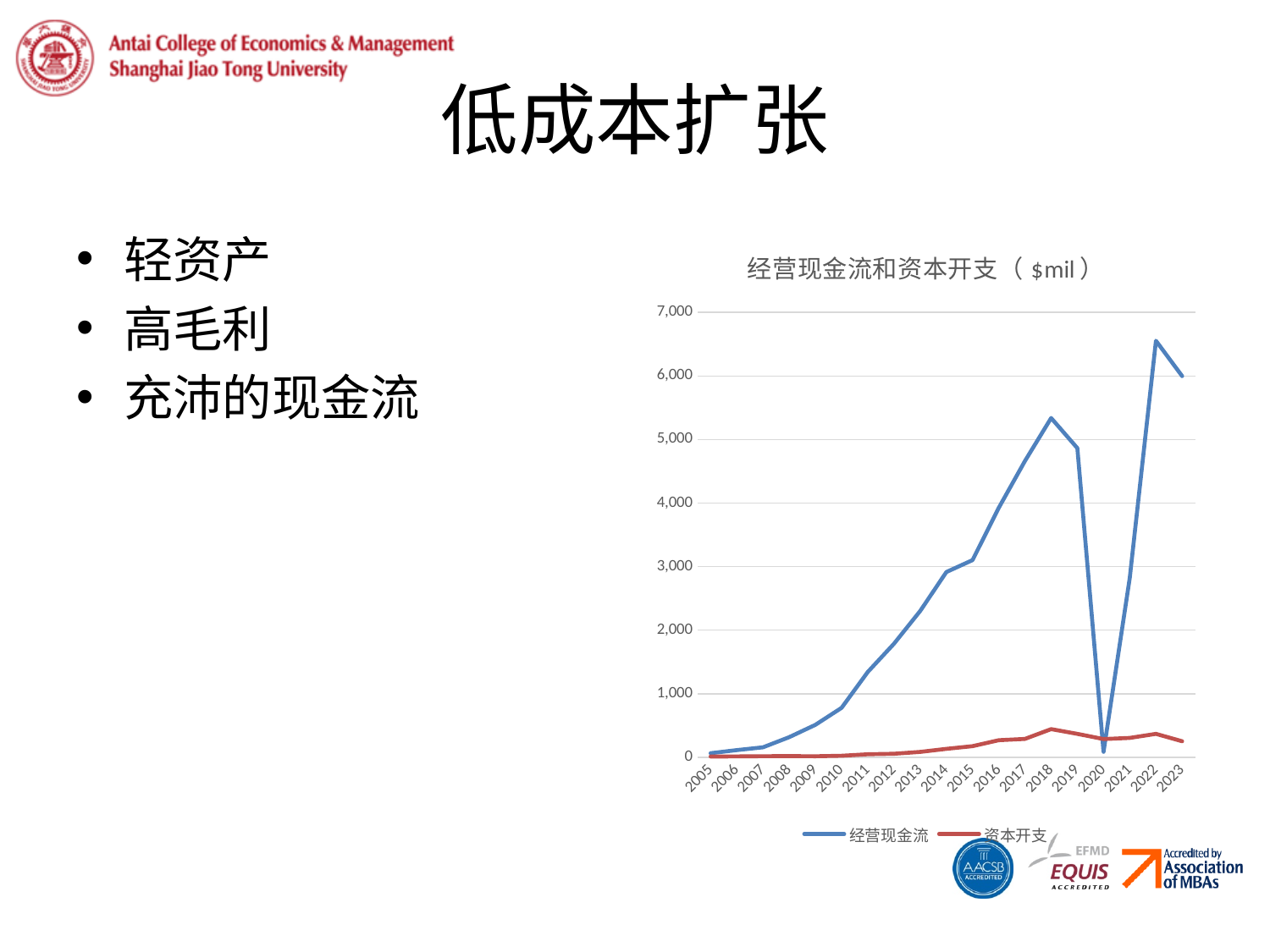
In which year does 经营现金流 reach its highest value? 2022 Is the value of 资本开支 in 2018 greater or less than 1,000? less Which series is drawn in red in the chart? 资本开支 Does 经营现金流 generally rise or fall from 2005 to 2018? rise How many years are plotted along the x axis of the chart? 19 Which year has the larger 经营现金流, 2022 or 2023? 2022 Is the value of 经营现金流 in 2022 greater or less than 6,000? greater Is the value of 经营现金流 in 2020 greater or less than 1,000? less How many series does the chart legend list? 2 What is the title of the chart? 经营现金流和资本开支（$mil） What kind of chart is shown on the slide? line chart